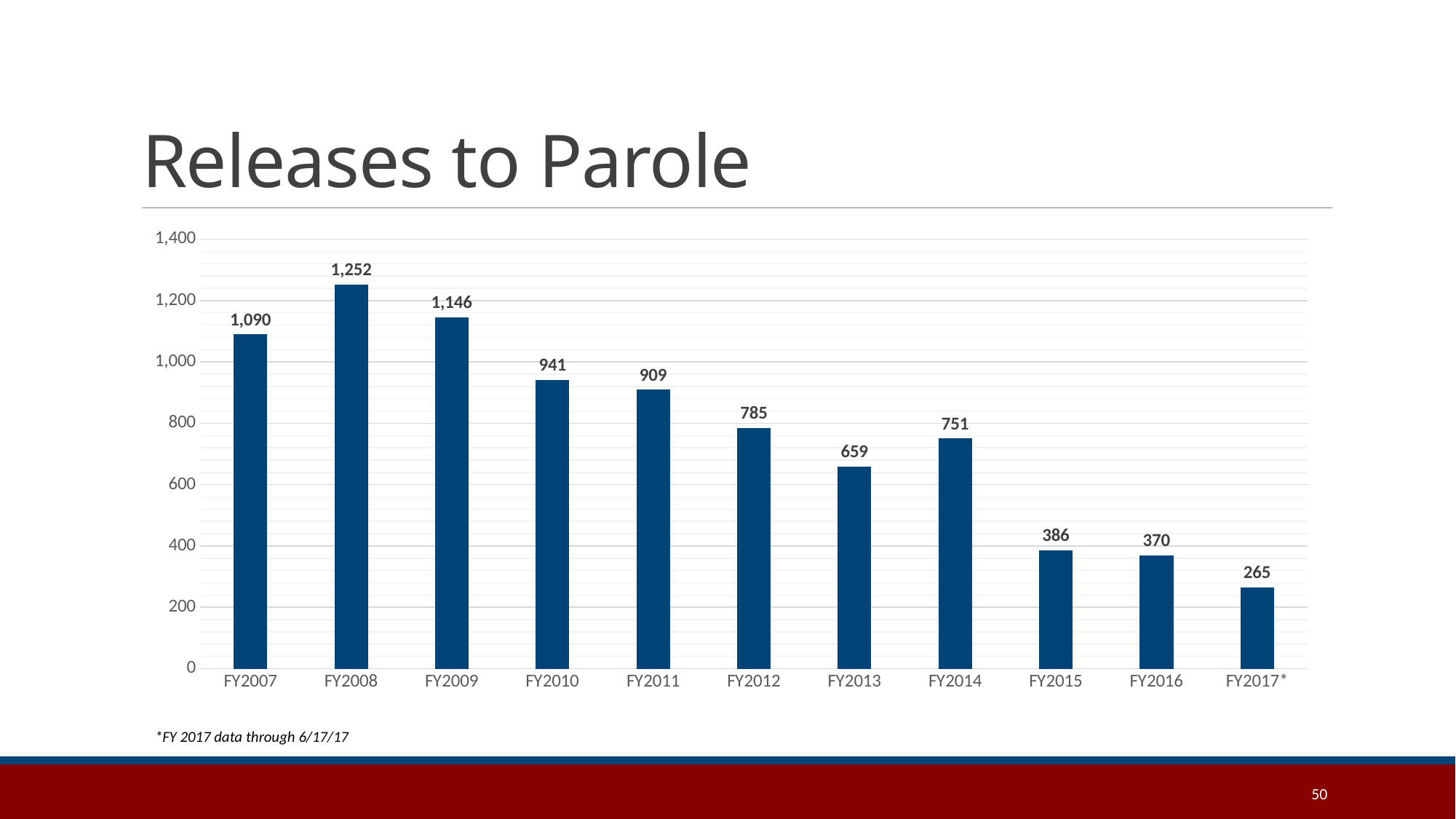
Which is larger, the value for FY2012 or the value for FY2014? FY2012 What kind of chart is shown on the slide? bar chart Is the value for FY2011 greater or less than 1,000? less What is the difference between the values for FY2015 and FY2016? 16 What is the value for FY2013? 659 Which fiscal year has the lowest value? FY2017* How many fiscal years are shown on the x axis? 11 Which fiscal year has the highest value? FY2008 What is the difference between the values for FY2007 and FY2010? 149 What is the value for FY2008? 1,252 What is the value for FY2017*? 265 What is the title of the slide? Releases to Parole